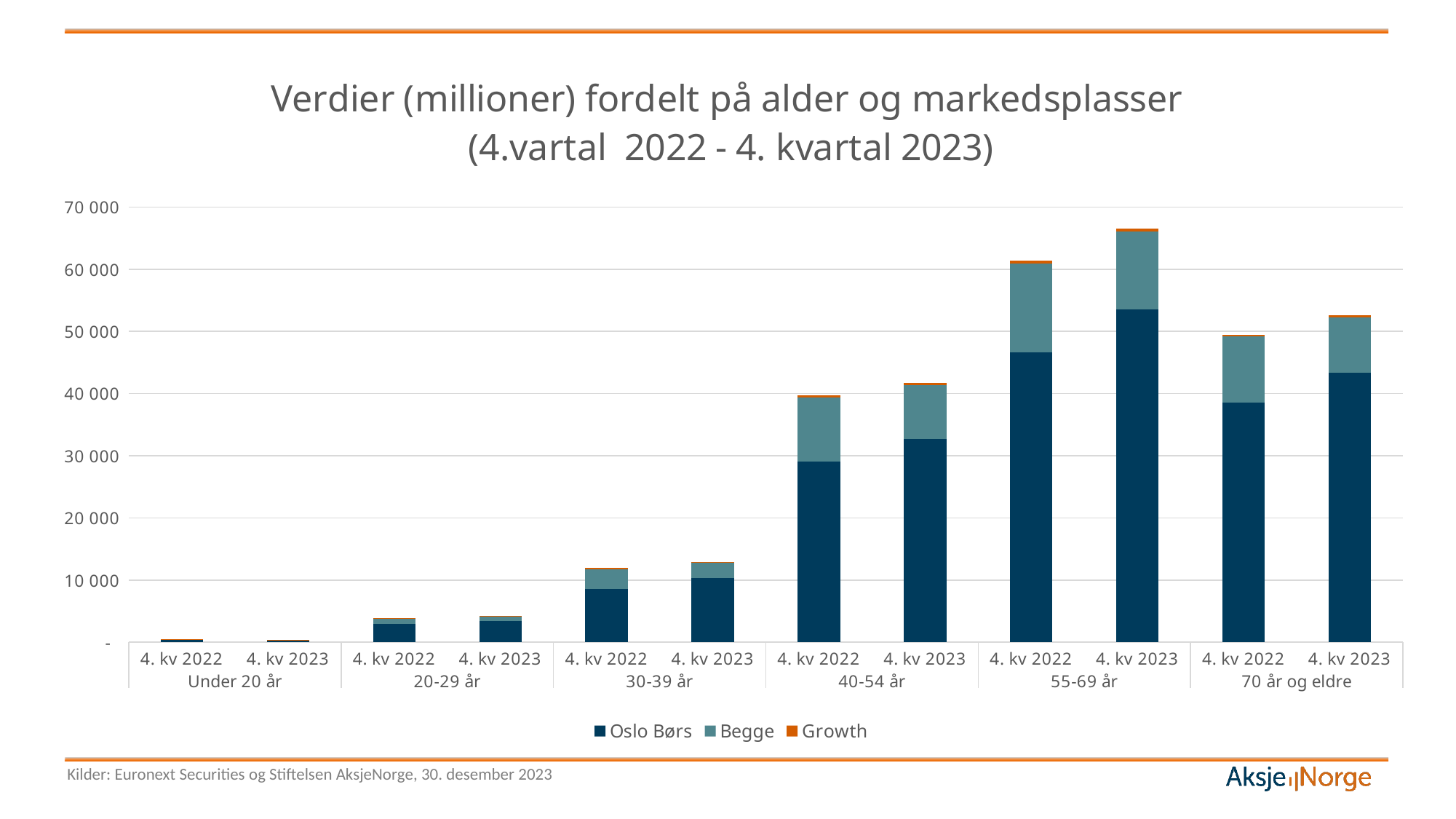
Is the total for 55-69 år in 4. kv 2023 greater or less than 60 000? greater Is the total for 70 år og eldre in 4. kv 2023 greater or less than 50 000? greater What kind of chart is shown on the slide? Stacked bar chart Is the total for 20-29 år in 4. kv 2022 greater or less than 10 000? less Moving from Under 20 år to 55-69 år, do the bar totals rise or fall? rise How many series does the legend list? 3 Which bar has the highest total value? 55-69 år, 4. kv 2023 Which series are listed in the legend? Oslo Børs, Begge, Growth How many age groups are shown along the x axis? 6 How many bars are plotted in total? 12 Which age group has the lowest values? Under 20 år Which is larger: the total for 55-69 år in 4. kv 2023 or the total for 70 år og eldre in 4. kv 2023? 55-69 år, 4. kv 2023